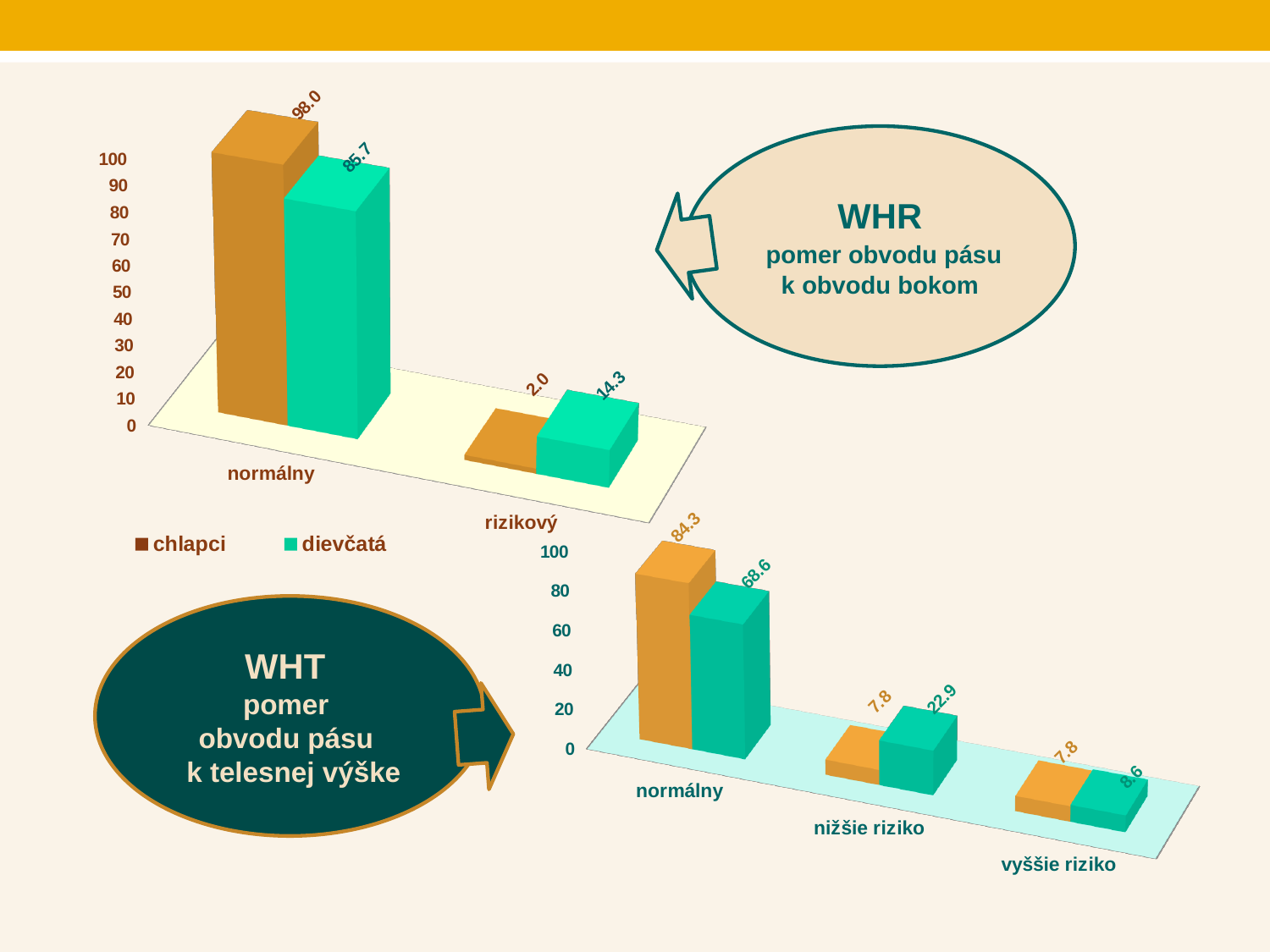
In the WHT chart (bottom right), which category has the highest value for dievčatá? normálny In the WHR chart (top left), what is the value for dievčatá in the rizikový category? 14.3 In the WHT chart (bottom right), what is the difference between chlapci and dievčatá in the normálny category? 15.7 In the WHR chart (top left), which series has the larger value in the rizikový category? dievčatá In the WHT chart (bottom right), what is the value for chlapci in the vyššie riziko category? 7.8 In the WHT chart (bottom right), how many categories are shown on the x axis? 3 In the WHR chart (top left), how many categories are shown on the x axis? 2 What kind of chart is the WHT chart (bottom right)? bar chart In the WHR chart (top left), what is the difference between chlapci and dievčatá in the normálny category? 12.3 How many series does the legend list for the charts on the slide? 2 In the WHT chart (bottom right), what is the value for dievčatá in the nižšie riziko category? 22.9 In the WHR chart (top left), what is the value for chlapci in the normálny category? 98.0